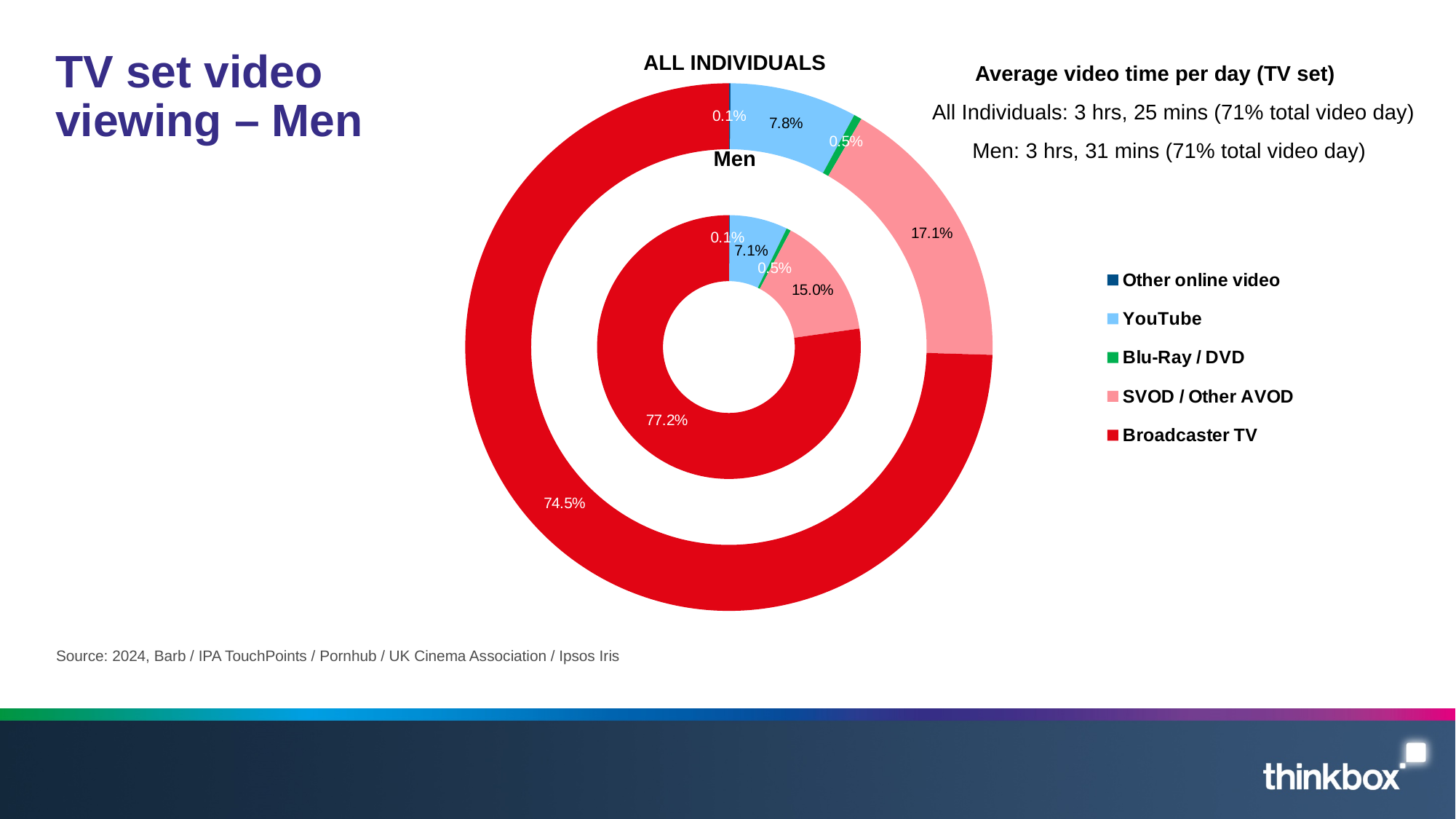
Which category has the smallest share in the All Individuals ring? Other online video What is the SVOD / Other AVOD share in the All Individuals ring? 17.1% Is the YouTube share larger for All Individuals or for Men? All Individuals What is the YouTube share in the Men ring? 7.1% What share of TV set video viewing does Broadcaster TV account for in the Men ring? 77.2% What kind of chart is shown on the slide? Doughnut chart Which category has the largest share in the Men ring? Broadcaster TV What share of TV set video viewing does Broadcaster TV account for in the All Individuals ring? 74.5% How many categories does the legend list? 5 What is the Blu-Ray / DVD share in the Men ring? 0.5% Which colour represents Broadcaster TV in the chart? Red What is the difference between the SVOD / Other AVOD share for All Individuals and for Men? 2.1%